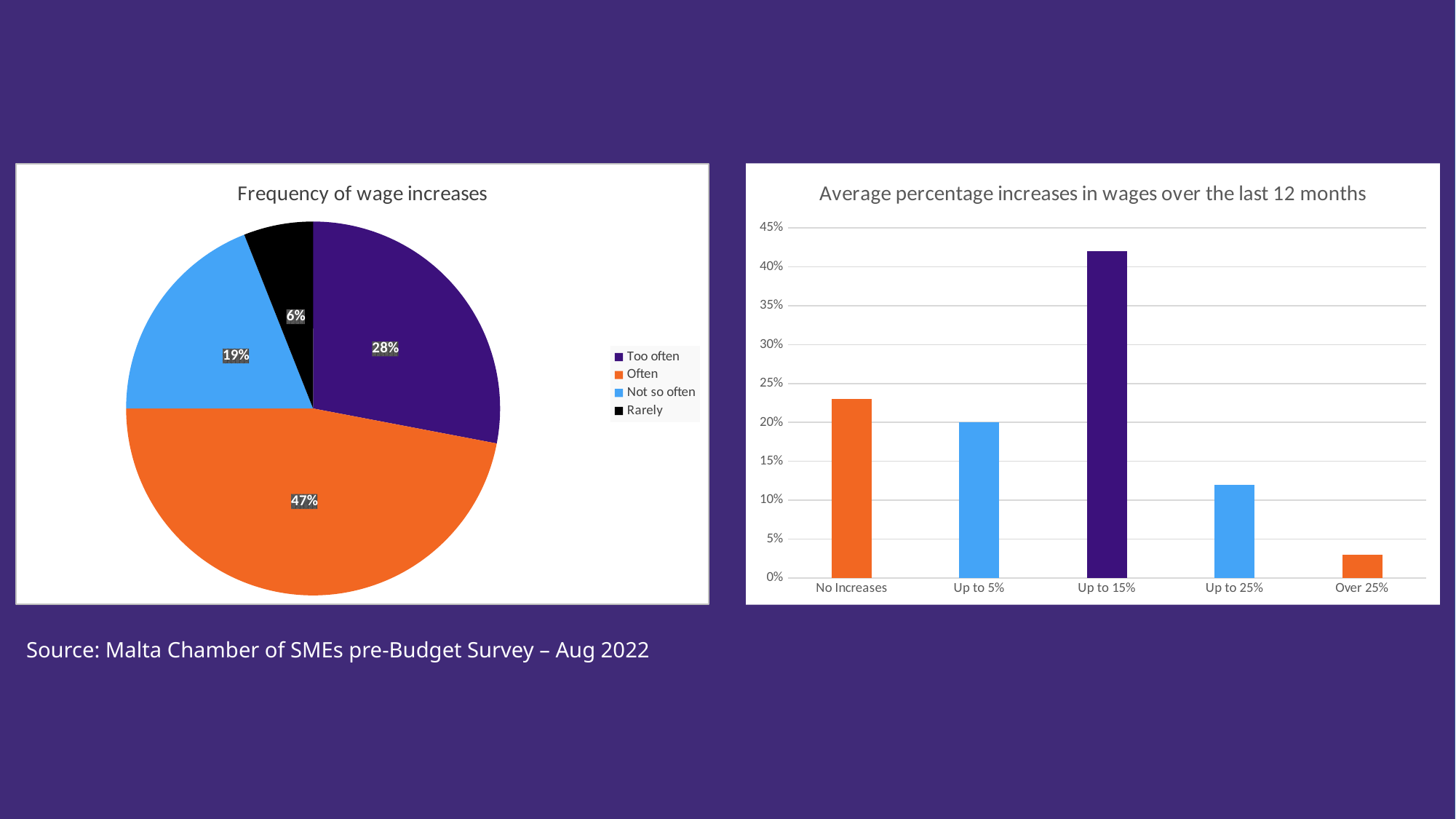
In the 'Frequency of wage increases' pie chart, which category has the largest share? Often In the 'Frequency of wage increases' pie chart, which category has the smallest share? Rarely In the 'Frequency of wage increases' pie chart, what percentage is shown for 'Rarely'? 6% In the 'Average percentage increases in wages over the last 12 months' chart, is the value for 'Up to 15%' greater or less than 40%? greater In the 'Average percentage increases in wages over the last 12 months' chart, which category has the highest bar? Up to 15% In the 'Average percentage increases in wages over the last 12 months' chart, which category has the lowest bar? Over 25% In the 'Frequency of wage increases' pie chart, how many categories does the legend list? 4 What kind of chart is 'Average percentage increases in wages over the last 12 months'? Bar chart In the 'Frequency of wage increases' pie chart, what percentage is shown for 'Often'? 47% In the 'Average percentage increases in wages over the last 12 months' chart, is the value for 'No Increases' larger than the value for 'Up to 25%'? Yes In the 'Frequency of wage increases' pie chart, which colour represents 'Not so often'? Light blue In the 'Frequency of wage increases' pie chart, what is the difference between the 'Too often' and 'Not so often' shares? 9%